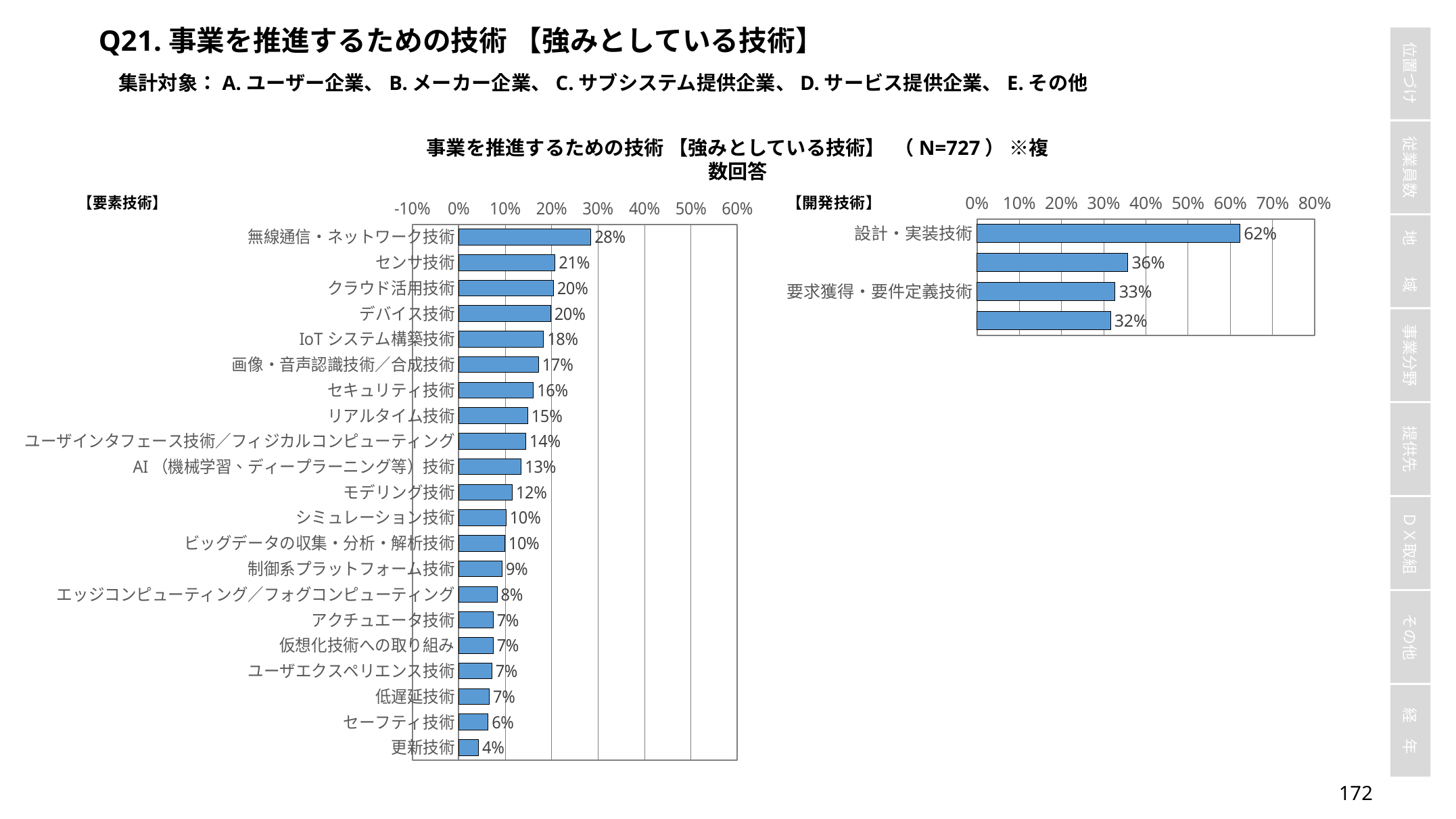
In the 【要素技術】 chart, what is the value for 無線通信・ネットワーク技術? 28% In the 【開発技術】 chart, what is the value for 要求獲得・要件定義技術? 33% In the 【要素技術】 chart, which is larger, IoTシステム構築技術 or リアルタイム技術? IoTシステム構築技術 How many bars are plotted in the 【開発技術】 chart? 4 How many categories are plotted in the 【要素技術】 chart? 21 In the 【開発技術】 chart, what is the value for 設計・実装技術? 62% What kind of chart is the 【開発技術】 chart? Bar chart In the 【要素技術】 chart, what is the value for セキュリティ技術? 16% In the 【要素技術】 chart, what is the difference between センサ技術 and モデリング技術? 9% In the 【要素技術】 chart, what is the value for AI（機械学習、ディープラーニング等）技術? 13% In the 【要素技術】 chart, which category has the lowest value? 更新技術 In the 【要素技術】 chart, which category has the highest value? 無線通信・ネットワーク技術